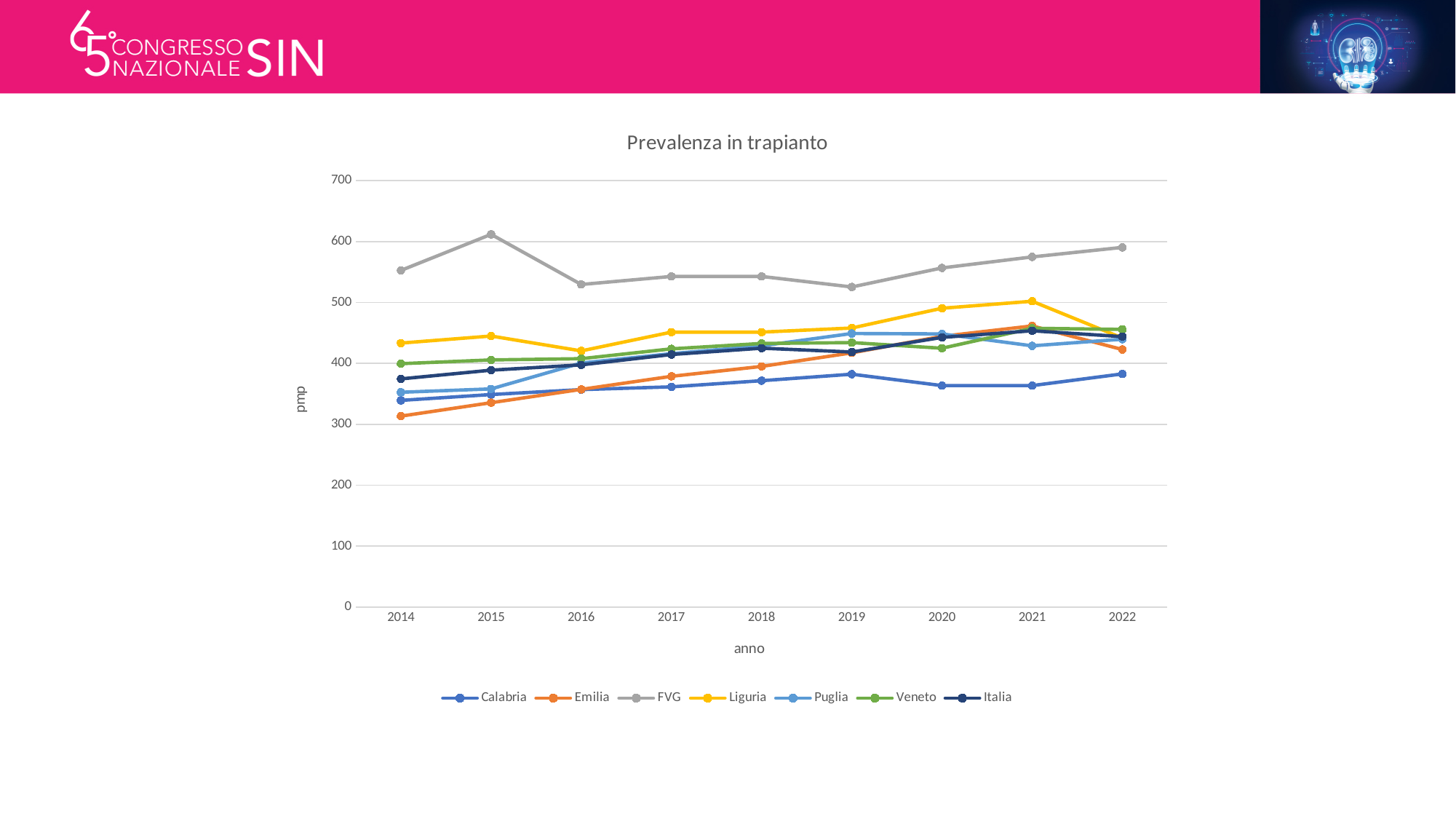
Is the value for Emilia in 2014 greater or less than 350? less Which series has the highest value in 2022? FVG Is the value for FVG in 2015 greater or less than 600? greater Which series has the lowest value in 2014? Emilia Is the value for Liguria in 2020 greater or less than 450? greater How many series does the legend list? 7 Does the FVG line rise or fall from 2019 to 2022? rise What kind of chart is shown on the slide? line chart How many years are plotted along the x axis? 9 Which is larger in 2021, the value for FVG or the value for Liguria? FVG What is the title of the chart? Prevalenza in trapianto Which series has the lowest value in 2022? Calabria